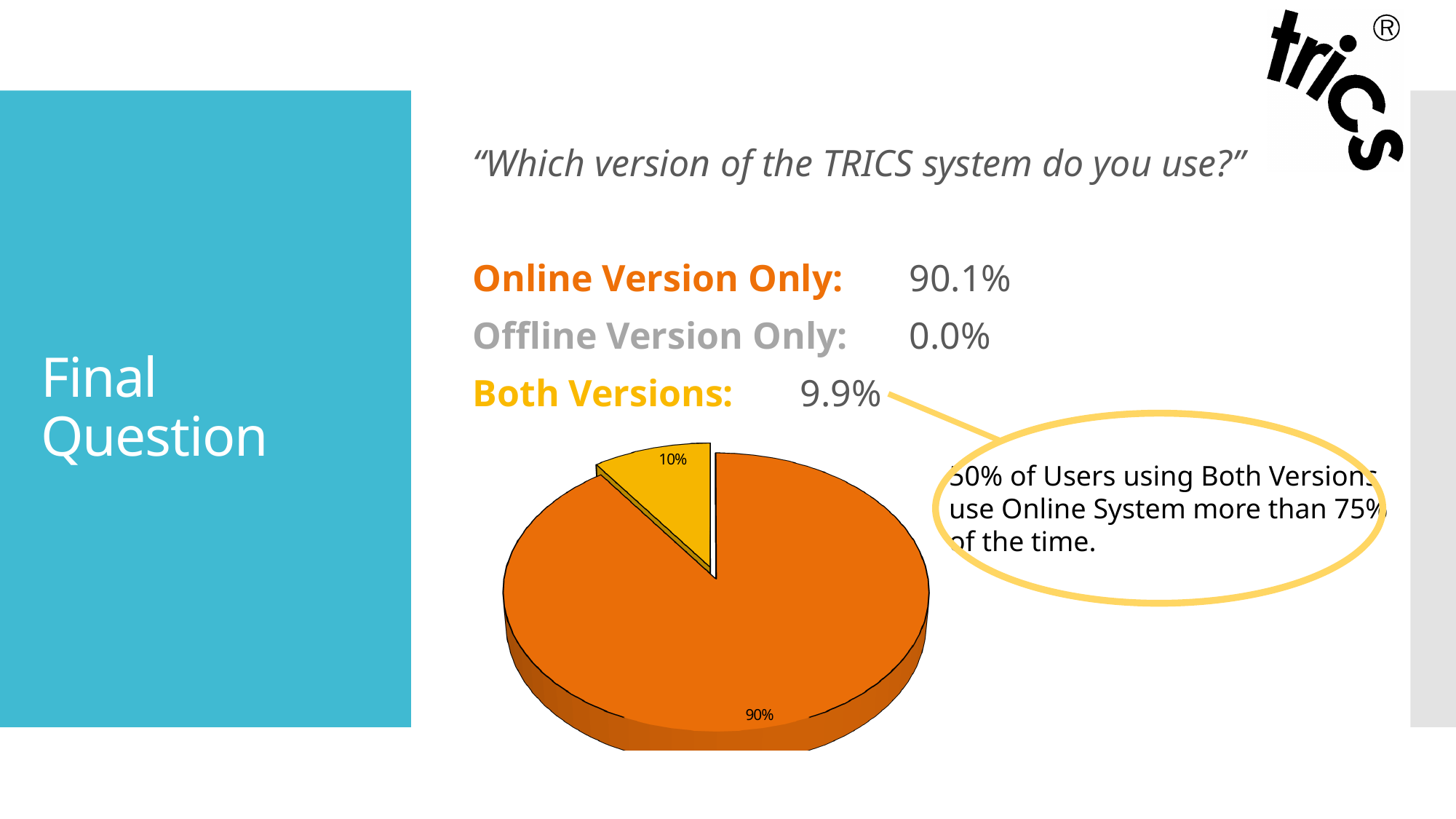
Is the orange slice or the yellow slice of the pie chart larger? the orange slice What percentage label is shown on the large orange slice of the pie chart? 90% Which slice of the pie chart is the smallest? the yellow slice (10%) According to the text on the slide, what percentage of respondents use Both Versions? 9.9% According to the text on the slide, what percentage of respondents use the Offline Version Only? 0.0% According to the text on the slide, what percentage of respondents use the Online Version Only? 90.1% What percentage label is shown on the small yellow slice of the pie chart? 10% How many slices with data labels are visible in the pie chart? 2 Which slice of the pie chart is the largest? the orange slice (90%) What is the difference between the two labelled slices of the pie chart? 80% What kind of chart is shown on the slide? pie chart What survey question does the pie chart on the slide illustrate? "Which version of the TRICS system do you use?"